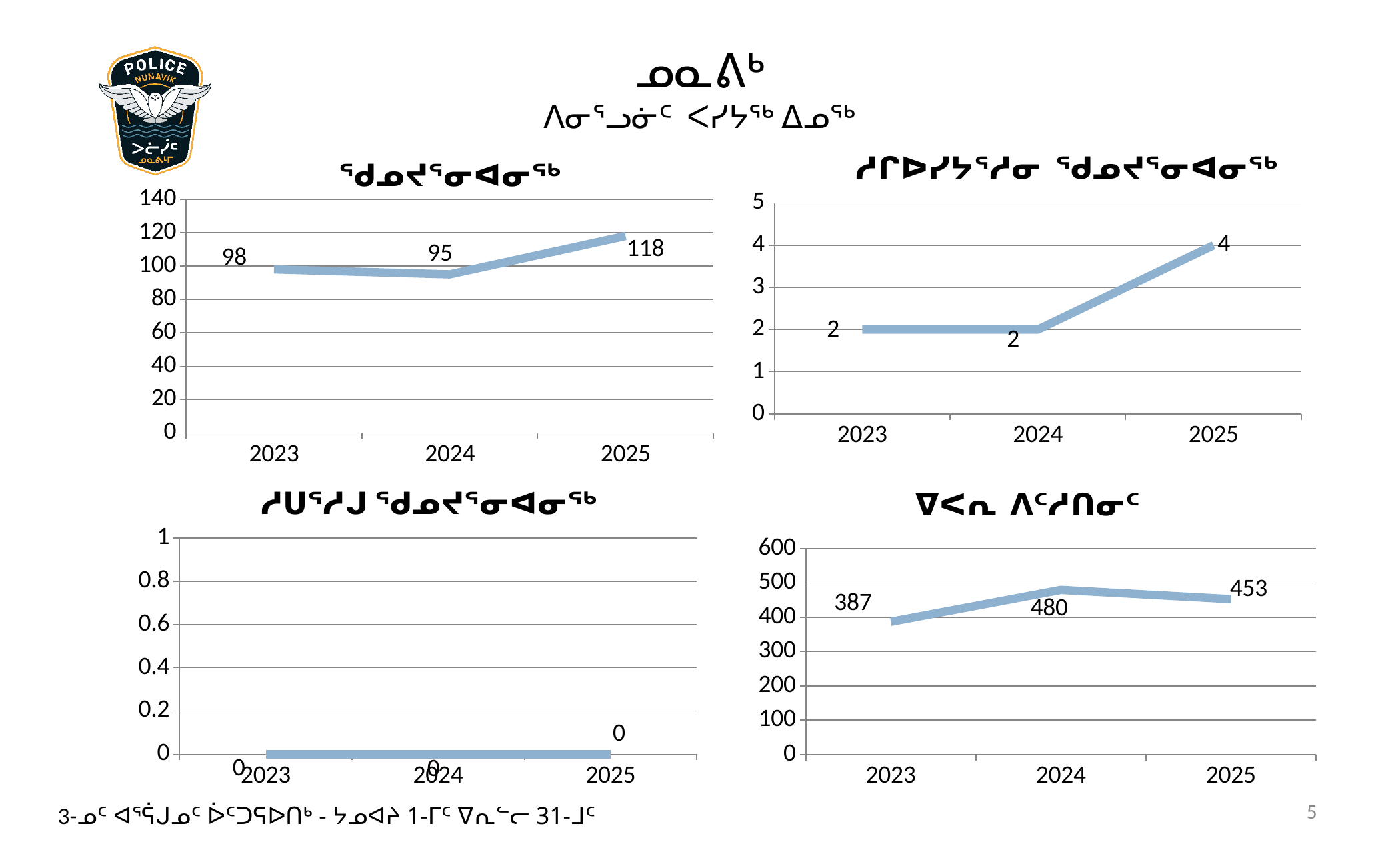
In the top-left chart, what is the value for 2025? 118 In the top-right chart, what is the value for 2023? 2 In the bottom-right chart, which year has the lowest value? 2023 In the bottom-right chart, is the value for 2023 larger or smaller than the value for 2025? smaller In the bottom-left chart, what is the value for 2025? 0 In the top-right chart, what is the value for 2025? 4 In the top-left chart, which year has the lowest value? 2024 In the bottom-right chart, what is the difference between the 2024 value and the 2025 value? 27 In the bottom-right chart, what is the value for 2024? 480 What kind of chart is the top-left chart? line chart In the top-left chart, what is the difference between the 2025 value and the 2023 value? 20 In the top-right chart, which year has the highest value? 2025